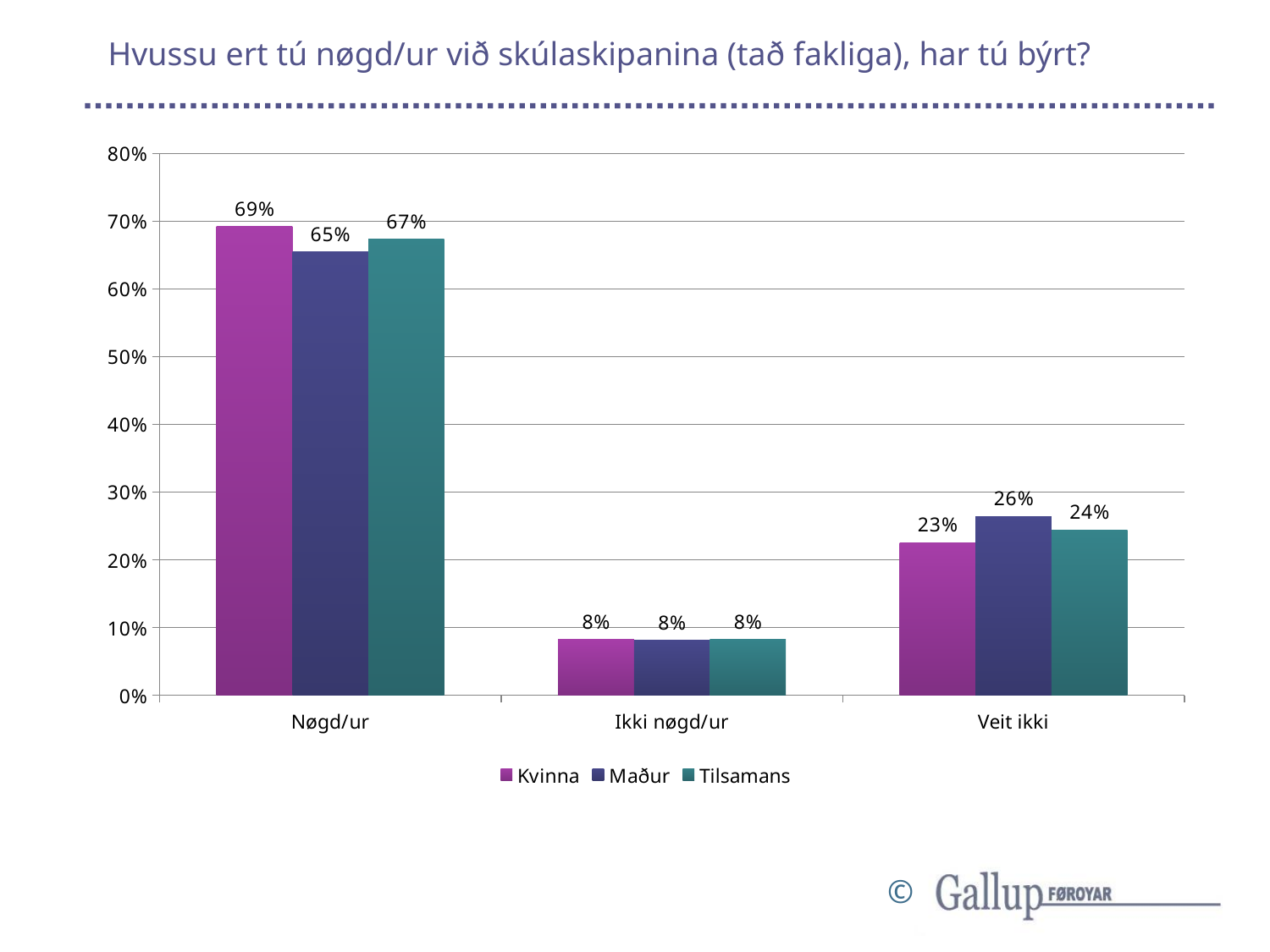
How many categories are shown on the x axis? 3 What kind of chart is shown on the slide? bar chart What is the value for Kvinna in the Nøgd/ur category? 69% Which category has the highest value for the Tilsamans series? Nøgd/ur How many series does the legend list? 3 Which series is shown in the teal colour in the legend? Tilsamans What is the value for Maður in the Veit ikki category? 26% Is the value for Tilsamans in the Veit ikki category greater or less than 30%? less Which category has the lowest value for the Kvinna series? Ikki nøgd/ur In the Veit ikki category, which is larger: the Kvinna value or the Maður value? Maður What is the value for Tilsamans in the Ikki nøgd/ur category? 8% What is the difference between the Kvinna and Maður values in the Nøgd/ur category? 4%